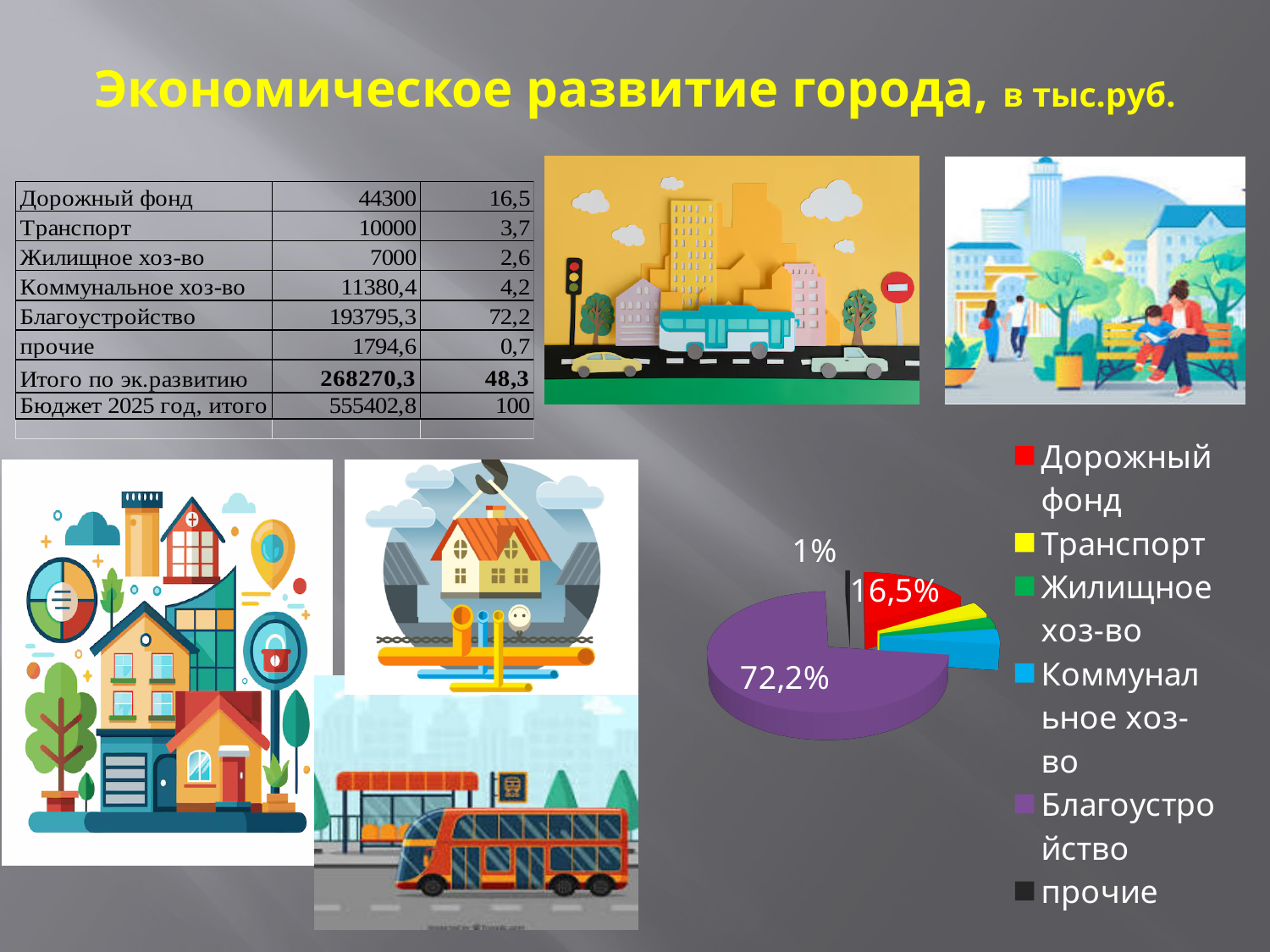
What share of the pie chart does Дорожный фонд take? 16,5% Which category has the largest slice in the pie chart? Благоустройство Which legend entry of the pie chart is shown in red? Дорожный фонд How many entries does the legend of the pie chart list? 6 What percentage label is shown next to the smallest slice of the pie chart? 1% What kind of chart is shown on the slide? pie chart What is the difference between the shares of Благоустройство and Дорожный фонд in the pie chart? 55,7% What share of the pie chart does Благоустройство take? 72,2% What colour is the Благоустройство slice in the pie chart? purple Which category has the smallest slice in the pie chart? прочие Which is larger in the pie chart, Дорожный фонд or Благоустройство? Благоустройство